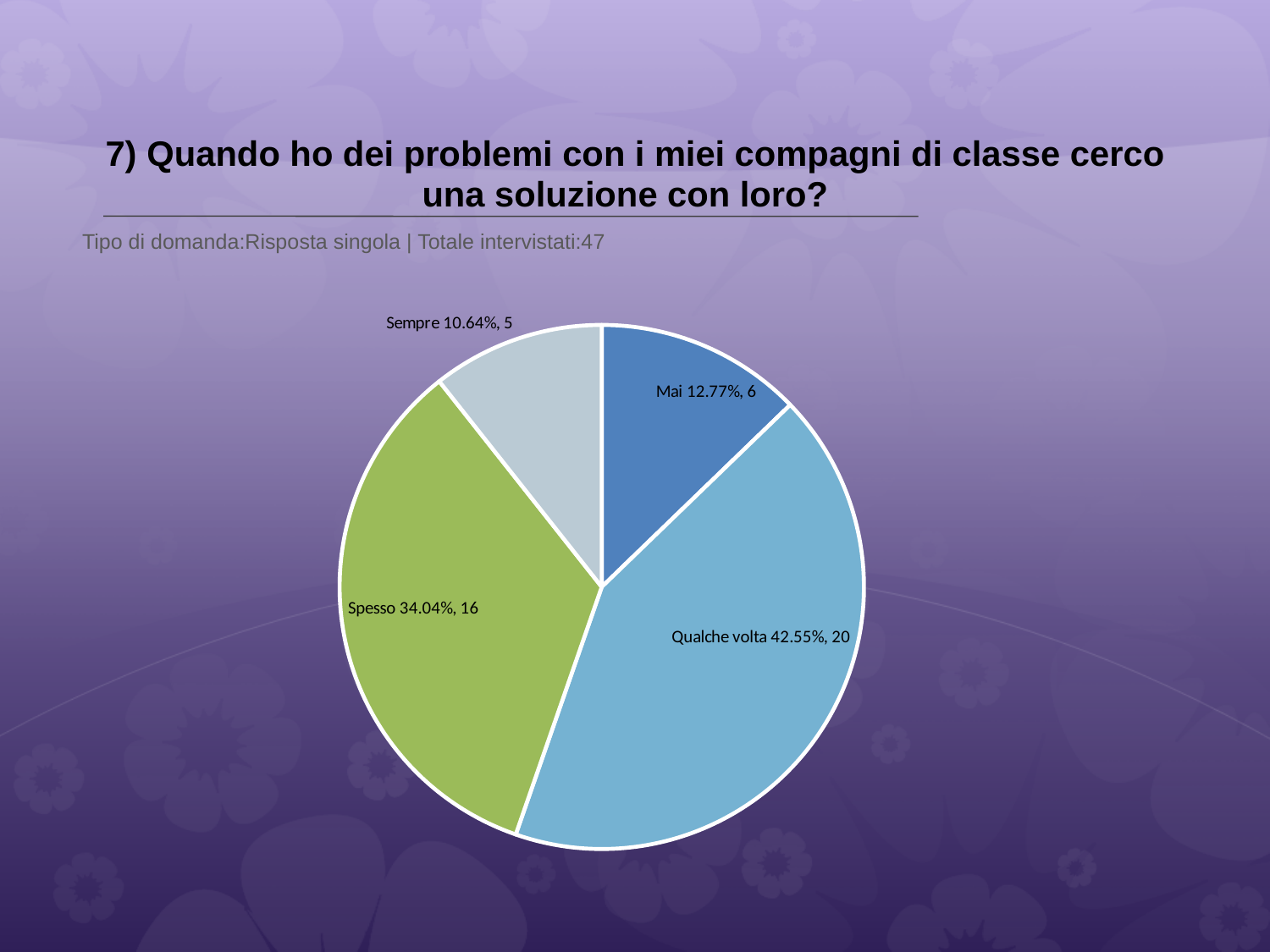
What is the count for "Qualche volta"? 20 Which category has the largest slice? Qualche volta What is the count for "Mai"? 6 What percentage is shown for "Spesso"? 34.04% What is the total number of respondents stated on the slide? 47 Which is larger, the count for "Mai" or the count for "Sempre"? Mai Which category has the smallest slice? Sempre What share of the pie does "Qualche volta" represent? 42.55% How many slices does the pie chart have? 4 What percentage is shown for "Sempre"? 10.64% What kind of chart is shown on the slide? pie chart What is the difference in count between "Qualche volta" and "Spesso"? 4